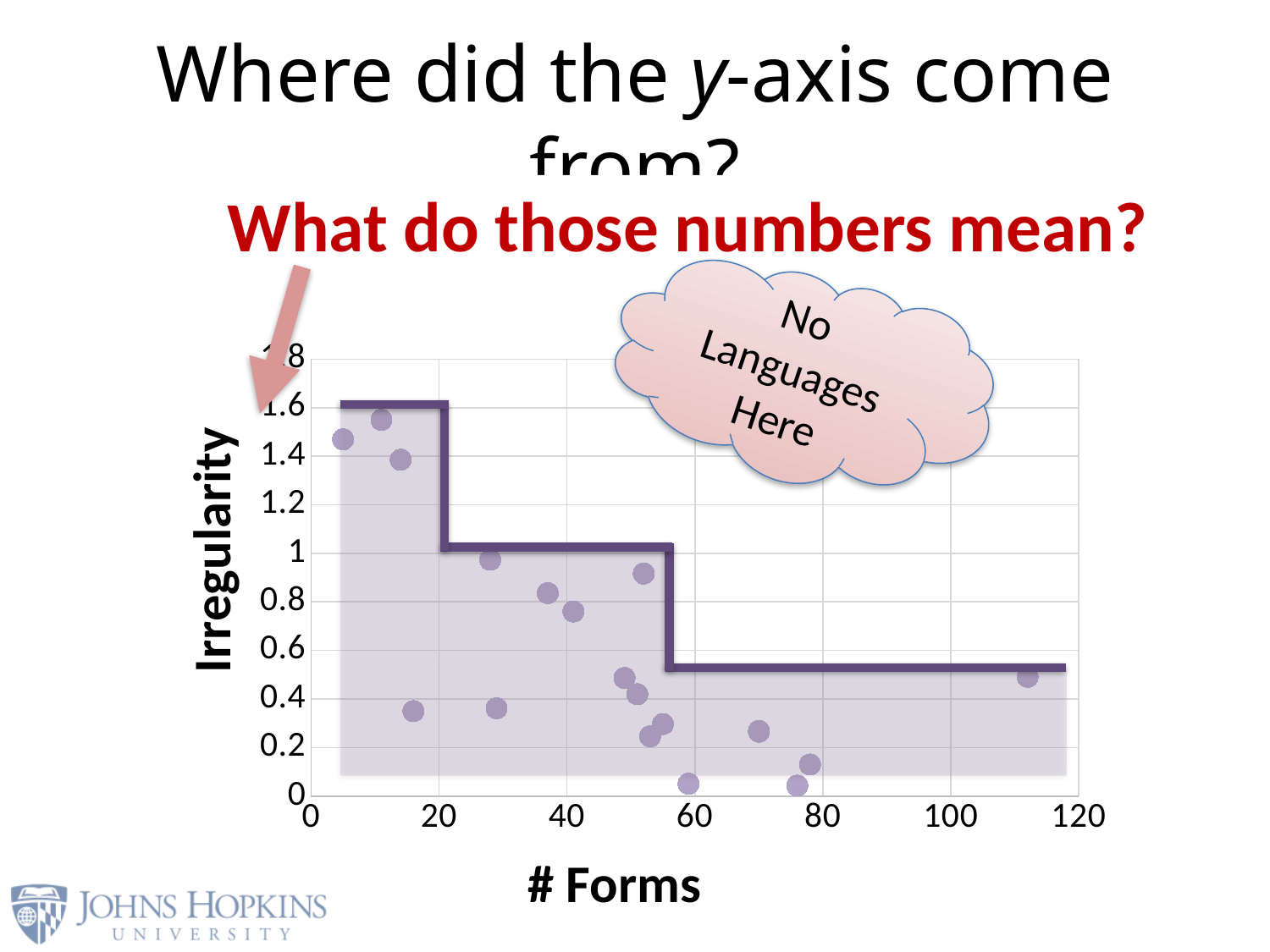
Is the Irregularity value for the point at about 16 forms greater or less than 0.6? less What is the label of the x-axis of the chart? # Forms Is the Irregularity value for the point at about 112 forms greater or less than 0.6? less Is the Irregularity value for the point at about 11 forms greater or less than 1.4? greater As # Forms increases along the x-axis, do the Irregularity values generally rise or fall? fall What is the label of the y-axis of the chart? Irregularity What kind of chart is shown on the slide? scatter chart What is the highest tick value shown on the x-axis of the chart? 120